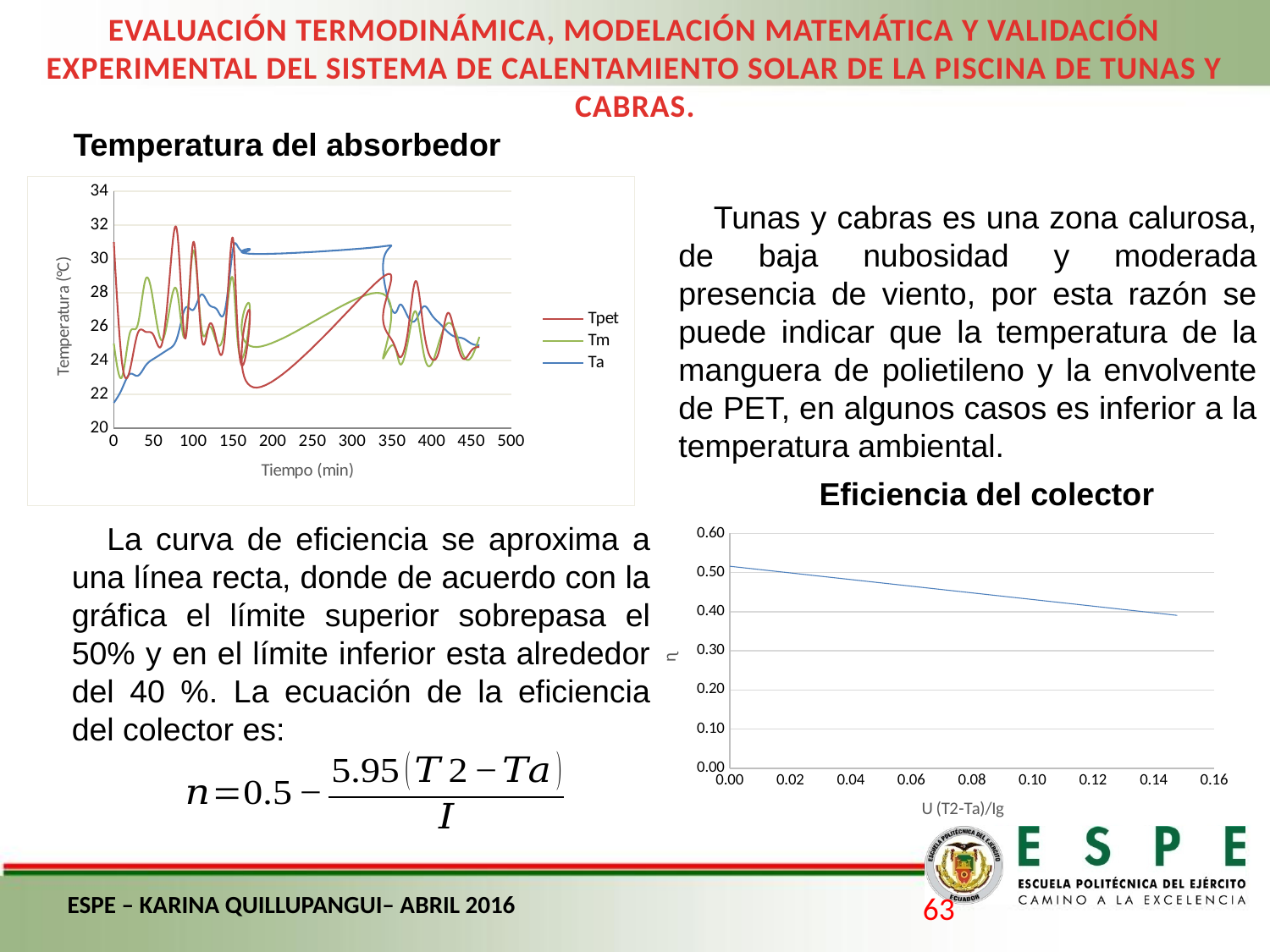
In the 'Eficiencia del colector' chart, what kind of chart is shown? line chart In the 'Temperatura del absorbedor' chart, how many series does the legend list? 3 In the 'Temperatura del absorbedor' chart, what is the label of the x axis? Tiempo (min) In the 'Temperatura del absorbedor' chart, is the value of Ta at 0 min greater or less than 24? less In the 'Eficiencia del colector' chart, do the values rise or fall as U (T2-Ta)/Ig increases? fall In the 'Temperatura del absorbedor' chart, is the value of Tm at 300 min greater or less than 26? greater In the 'Temperatura del absorbedor' chart, what kind of chart is shown? line chart In the 'Eficiencia del colector' chart, is the value at U = 0.08 greater or less than 0.40? greater In the 'Temperatura del absorbedor' chart, what are the legend entries? Tpet, Tm, Ta In the 'Temperatura del absorbedor' chart, at 200 min, which series has the larger value, Ta or Tpet? Ta